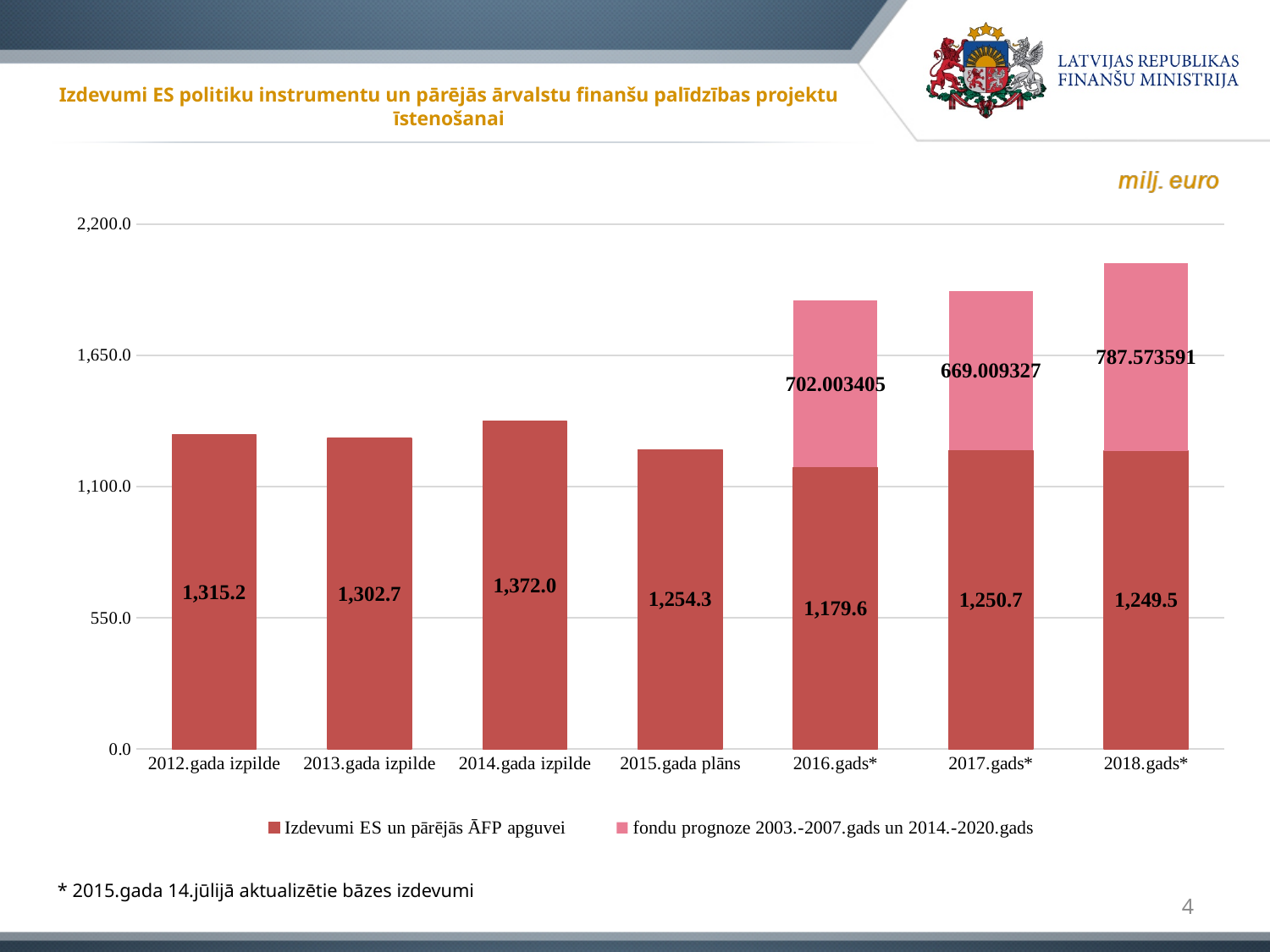
What is the value of 'Izdevumi ES un pārējās ĀFP apguvei' for 2014.gada izpilde? 1,372.0 Which is larger: the 'fondu prognoze' value for 2016.gads* or for 2017.gads*? 2016.gads* Is the total height of the stacked bar for 2018.gads* greater or less than 1,650.0? greater What kind of chart is shown on the slide? stacked bar chart What is the difference between the 'Izdevumi ES un pārējās ĀFP apguvei' values for 2012.gada izpilde and 2013.gada izpilde? 12.5 Which category has the highest value for 'Izdevumi ES un pārējās ĀFP apguvei'? 2014.gada izpilde Which category has the lowest value for 'Izdevumi ES un pārējās ĀFP apguvei'? 2016.gads* How many series does the legend list? 2 How many categories are shown on the x axis? 7 What is the value of 'fondu prognoze 2003.-2007.gads un 2014.-2020.gads' for 2018.gads*? 787.573591 What is the total of the stacked bar for 2016.gads*? 1,881.603405 What is the value of 'Izdevumi ES un pārējās ĀFP apguvei' for 2016.gads*? 1,179.6